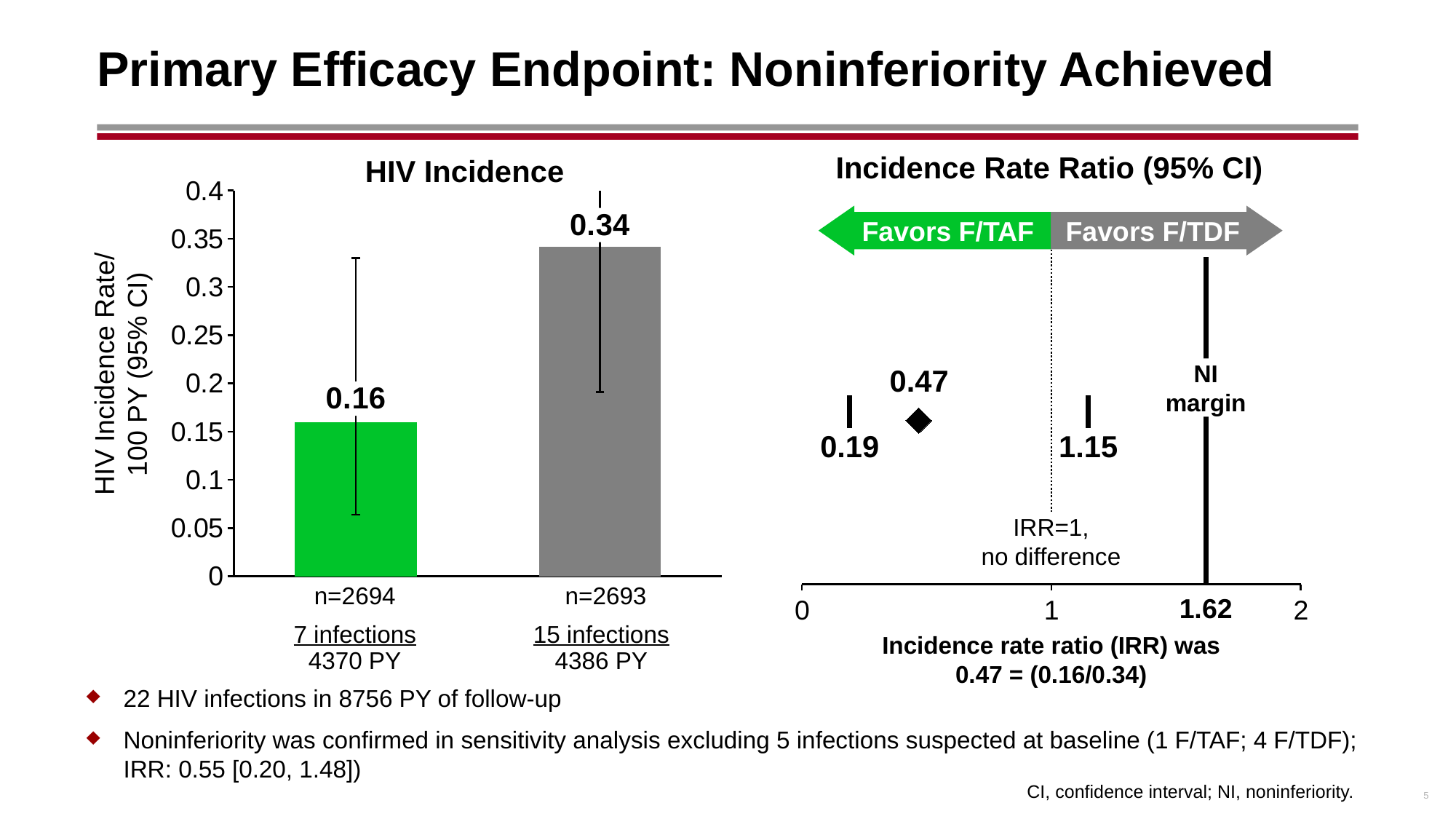
In the HIV Incidence chart, how many infections are reported for the n=2694 group? 7 infections What kind of chart is the HIV Incidence chart? Bar chart In the HIV Incidence chart, what is the HIV incidence rate for the n=2694 group? 0.16 In the Incidence Rate Ratio (95% CI) chart, what is the point estimate of the incidence rate ratio? 0.47 In the HIV Incidence chart, what is the HIV incidence rate for the n=2693 group? 0.34 In the HIV Incidence chart, what is the difference between the incidence rates of the n=2693 and n=2694 groups? 0.18 In the HIV Incidence chart, which group has the lower HIV incidence rate? n=2694 In the HIV Incidence chart, how many bars are plotted? 2 In the Incidence Rate Ratio (95% CI) chart, at what value is the NI margin drawn? 1.62 In the Incidence Rate Ratio (95% CI) chart, what is the upper bound of the 95% confidence interval? 1.15 In the HIV Incidence chart, which group has the higher HIV incidence rate? n=2693 In the HIV Incidence chart, is the incidence rate for the n=2693 group greater or less than 0.3? greater